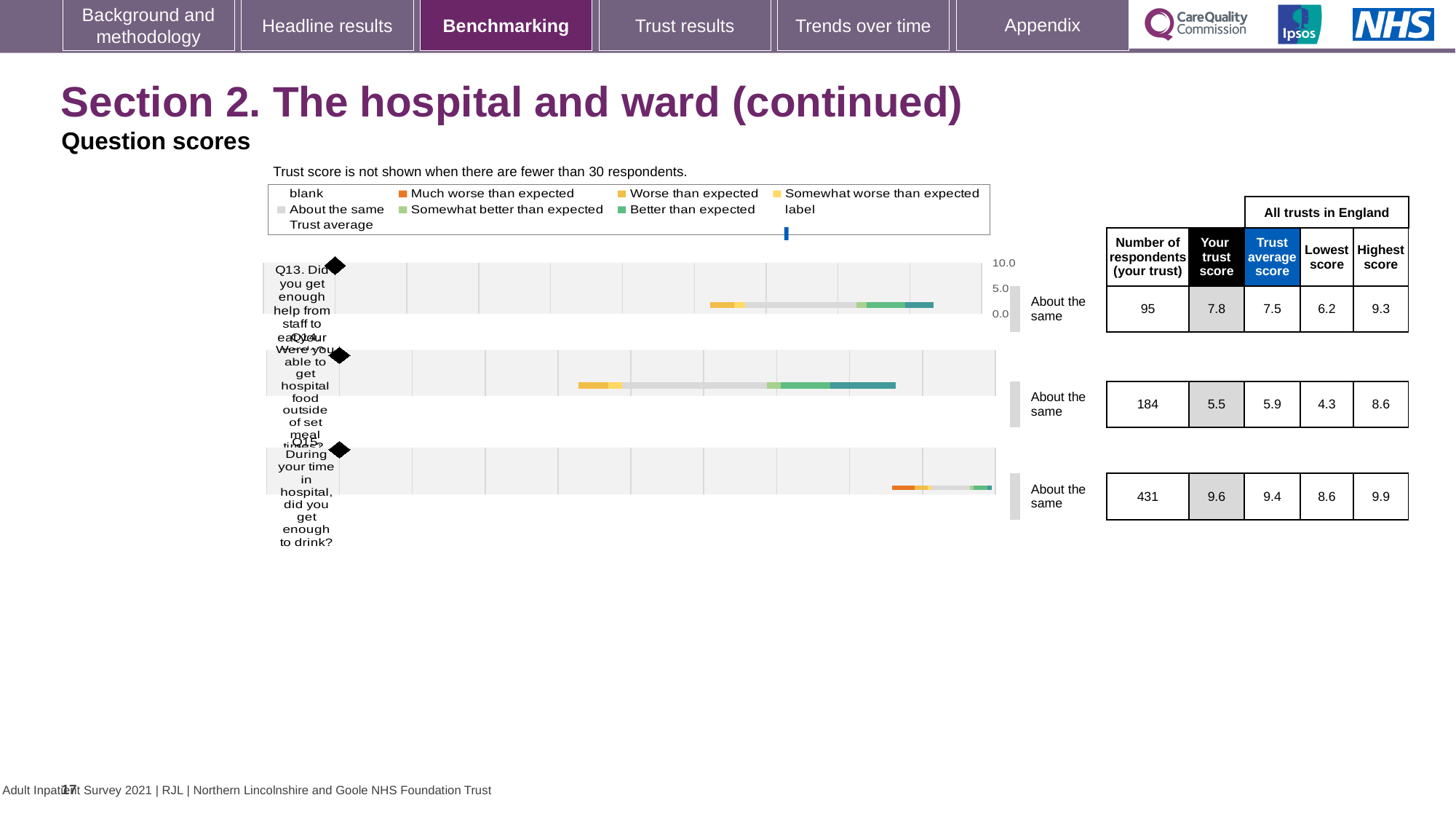
What is the lowest score across all trusts in England for Q15? 8.6 How many questions are plotted in the chart? 3 What is the difference between the trust score and the trust average score for Q13? 0.3 What benchmark category label is shown next to Q13? About the same What is the difference between the highest and lowest scores for Q15? 1.3 What kind of chart is used to show the question scores on this slide? bar chart What is the highest score across all trusts in England for Q14? 8.6 Which question has the highest 'Your trust score'? Q15 How many respondents answered Q15 (did you get enough to drink)? 431 For Q14, which is larger: the 'Your trust score' or the 'Trust average score'? Trust average score What is the 'Your trust score' for Q13 (Did you get enough help from staff to eat your meals)? 7.8 Which question has the lowest 'Your trust score'? Q14